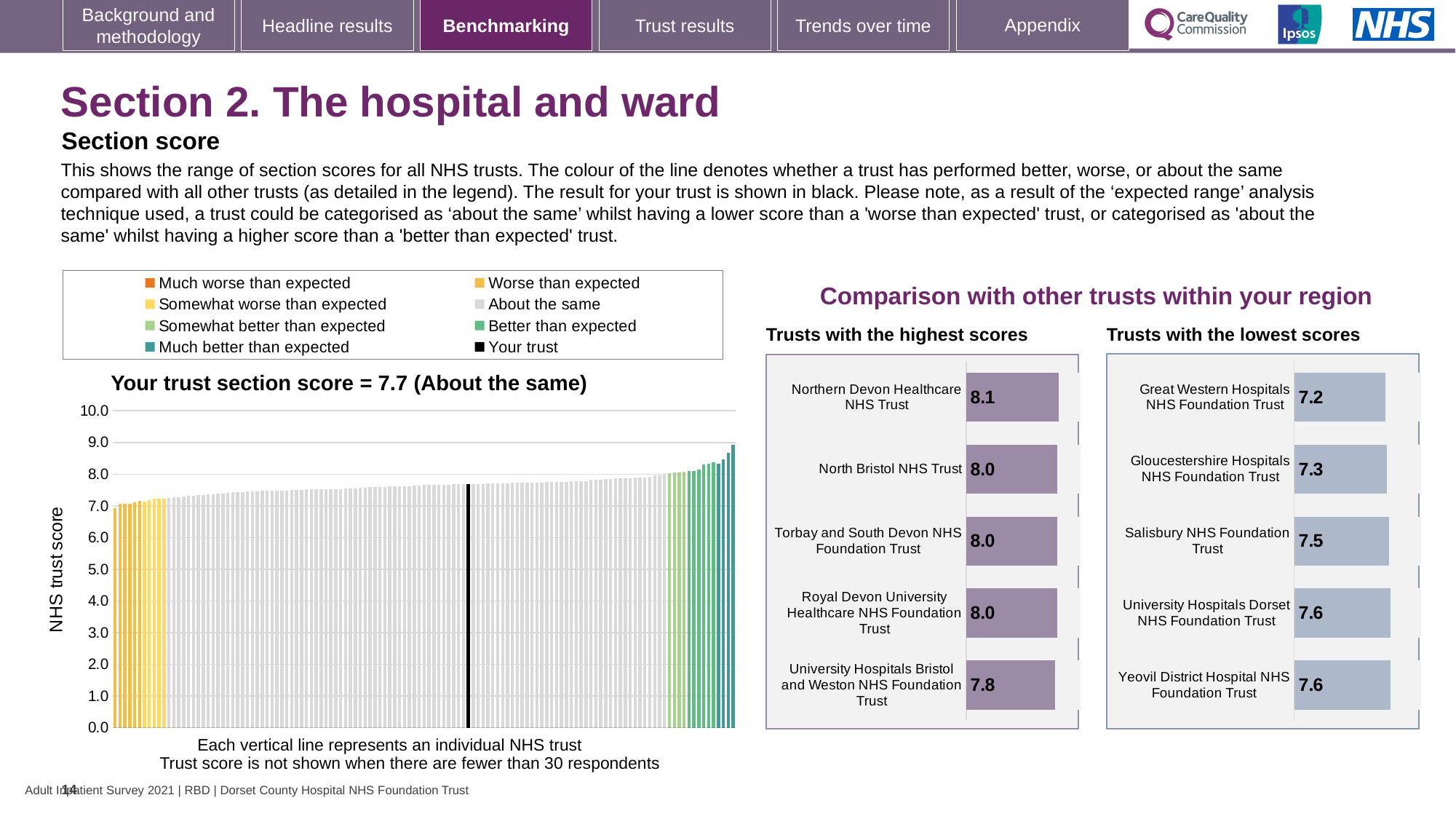
In the 'Trusts with the highest scores' chart, which trust has the lowest score? University Hospitals Bristol and Weston NHS Foundation Trust In the 'Trusts with the lowest scores' chart, which trust has the lowest score? Great Western Hospitals NHS Foundation Trust In the main chart of all NHS trusts, do the scores rise or fall from left to right? rise In the 'Trusts with the lowest scores' chart, what is the score for Salisbury NHS Foundation Trust? 7.5 In the 'Trusts with the lowest scores' chart, which has the higher score: Gloucestershire Hospitals NHS Foundation Trust or Salisbury NHS Foundation Trust? Salisbury NHS Foundation Trust In the 'Trusts with the lowest scores' chart, what is the difference between the scores of Yeovil District Hospital NHS Foundation Trust and Great Western Hospitals NHS Foundation Trust? 0.4 In the 'Trusts with the highest scores' chart, how many trusts are listed? 5 In the 'Trusts with the highest scores' chart, what is the score for Northern Devon Healthcare NHS Trust? 8.1 What is the section score for your trust shown in the title of the main chart? 7.7 In the 'Trusts with the highest scores' chart, what is the difference between the scores of Northern Devon Healthcare NHS Trust and University Hospitals Bristol and Weston NHS Foundation Trust? 0.3 How many entries does the legend above the main chart list? 8 What kind of chart is the main chart showing the range of section scores for all NHS trusts? bar chart